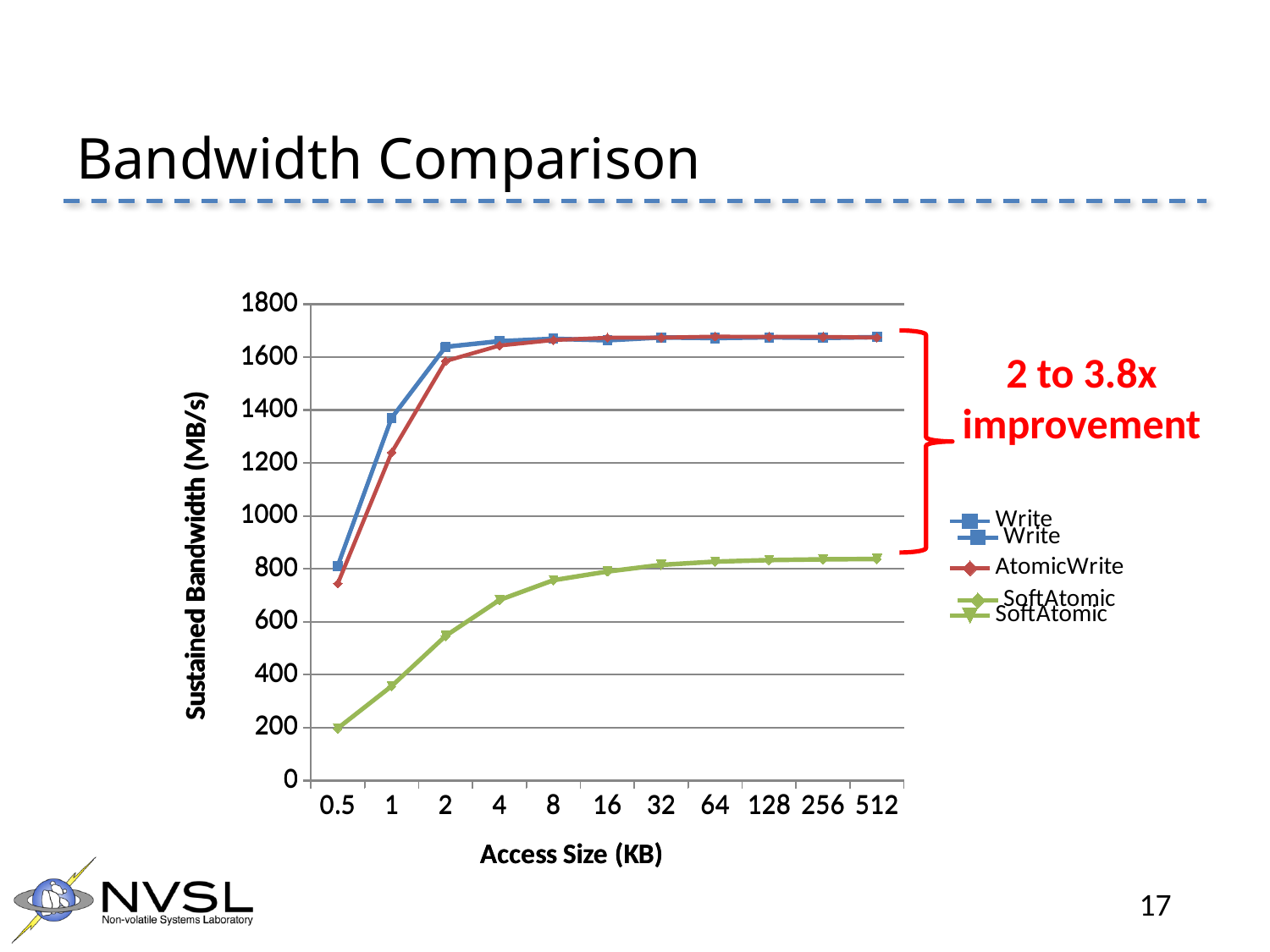
Is the Write value at an access size of 2 KB greater or less than 1400? greater How many access sizes are shown along the x axis? 11 What kind of chart is shown on the slide? Line chart What is the label of the y axis? Sustained Bandwidth (MB/s) Is the AtomicWrite value at an access size of 0.5 KB greater or less than 800? less Is the SoftAtomic value at an access size of 512 KB greater or less than 800? greater How many series (lines) are plotted on the chart? 3 At an access size of 1 KB, which is larger: Write or AtomicWrite? Write Does the SoftAtomic bandwidth rise or fall as access size increases? Rises Which series has the lowest sustained bandwidth at an access size of 512 KB? SoftAtomic